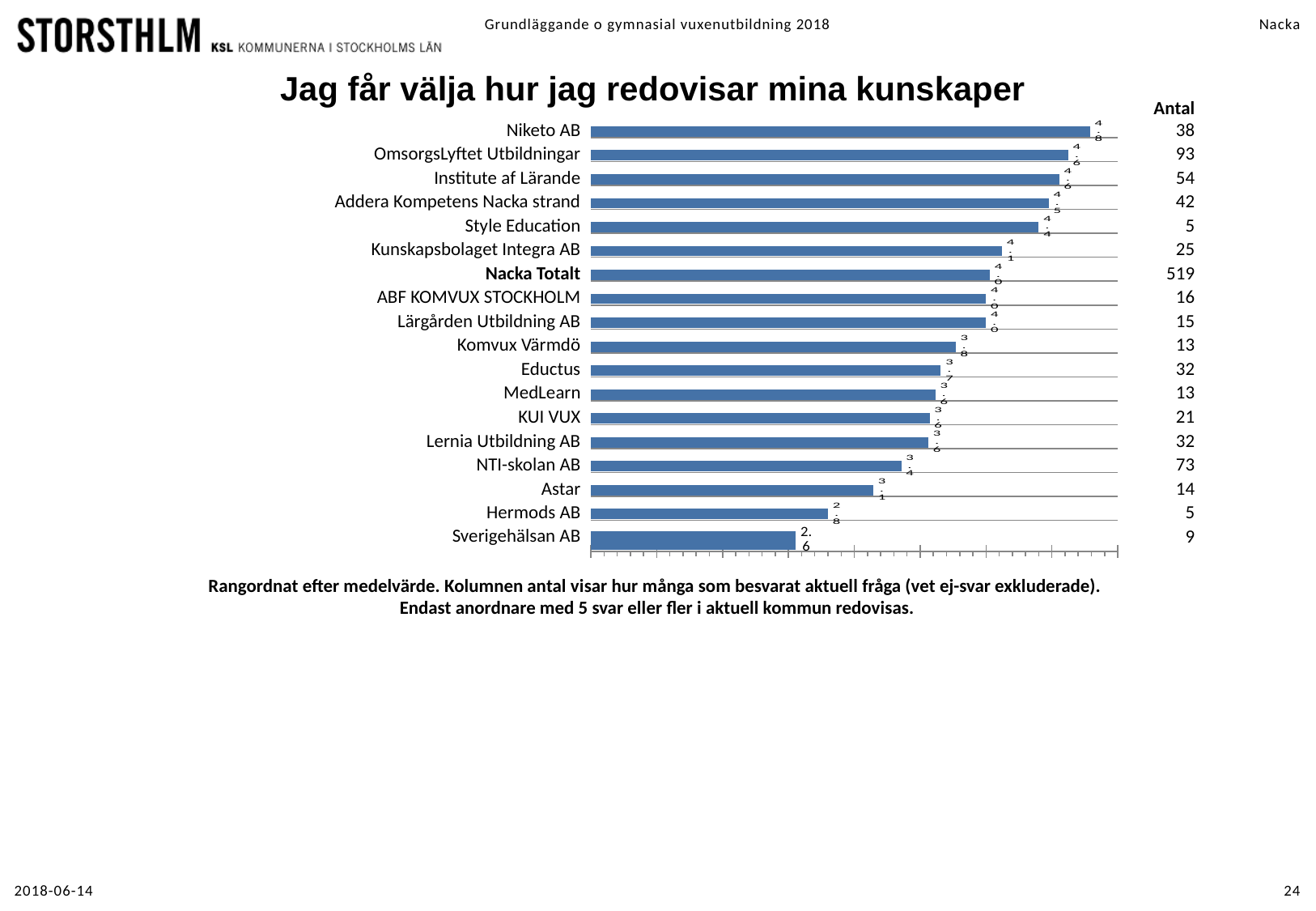
What is the value for NTI-skolan AB? 3.4 What is the title of the chart? Jag får välja hur jag redovisar mina kunskaper What is the difference between the values for Niketo AB and Sverigehälsan AB? 2.2 What is the value for Sverigehälsan AB? 2.6 What type of chart is shown on the slide? bar chart What is the value for Niketo AB? 4.8 How many categories are shown in the chart? 18 Which category has the lowest value? Sverigehälsan AB What is the value for Nacka Totalt? 4.0 Which has a larger value, Hermods AB or Astar? Astar What is the difference between the values for Style Education and Kunskapsbolaget Integra AB? 0.3 Which category has the highest value? Niketo AB